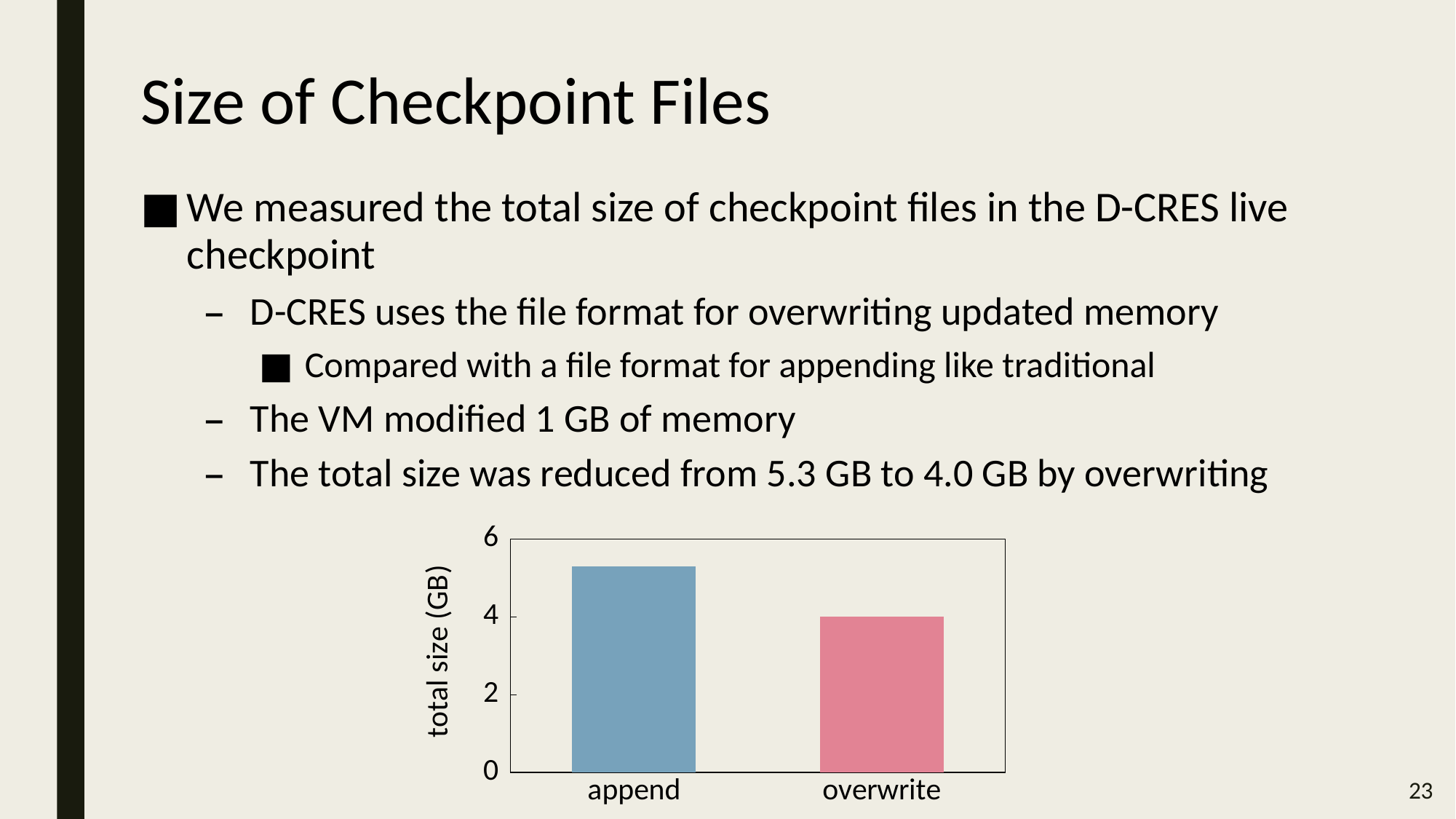
What is the label of the y axis of the chart? total size (GB) Is the value for append greater or less than 4? greater What colour is the bar for overwrite? pink What kind of chart is shown on the slide? bar chart According to the slide, what is the total size for append? 5.3 GB Is the value for overwrite greater or less than 2? greater Which category has the lowest total size in the chart? overwrite According to the slide, what is the total size for overwrite? 4.0 GB Which category has the highest total size in the chart? append Is the value for append greater or less than 6? less Which has a larger total size, append or overwrite? append How many categories are shown on the x axis of the chart? 2